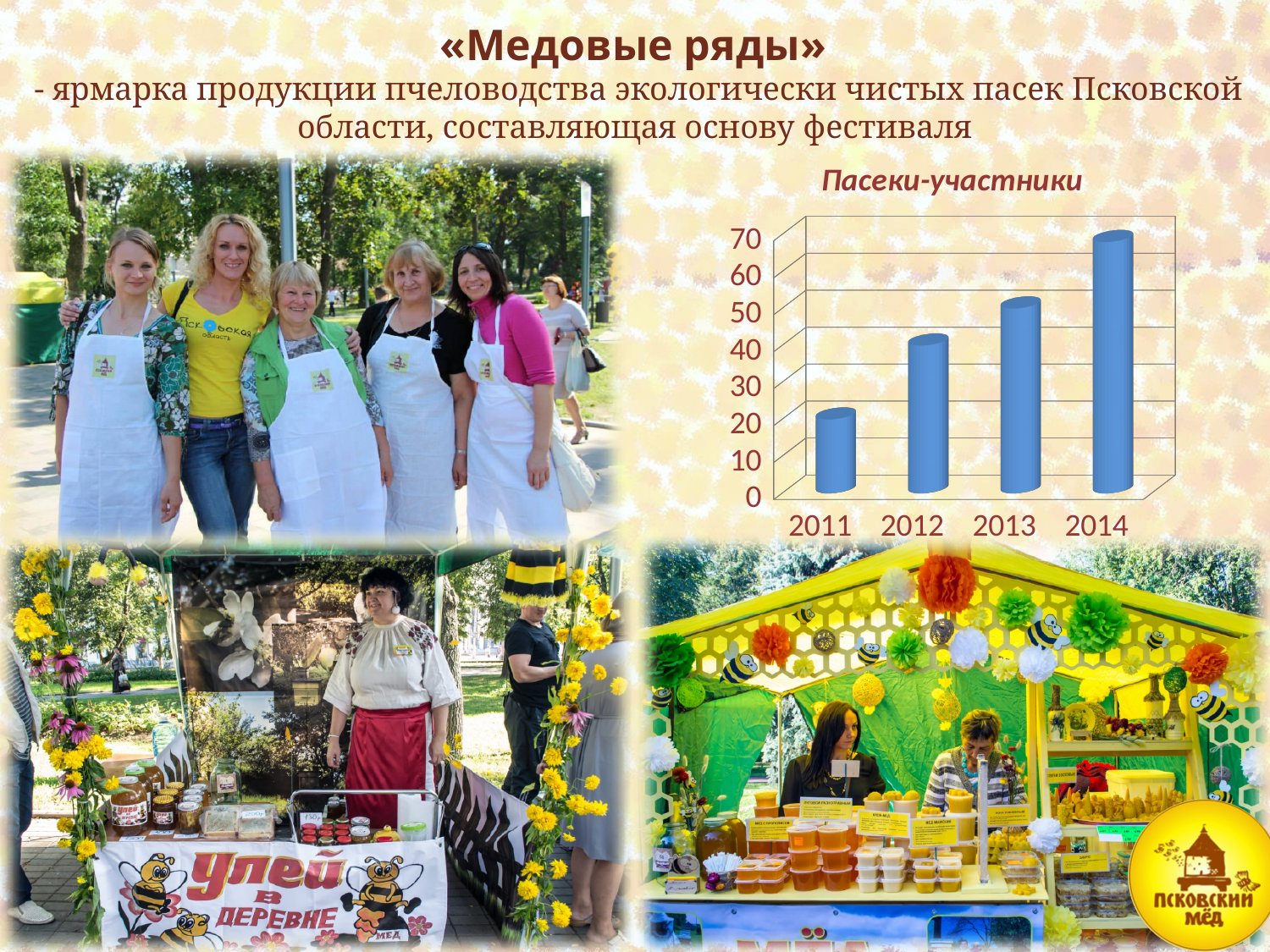
Which is larger, the value for 2012 or the value for 2013? 2013 What is the title of the chart on the slide? Пасеки-участники What kind of chart is shown on the slide? bar chart What is the value for 2011 in the chart? 20 Is the value for 2012 greater or less than 30? greater Is the value for 2014 greater or less than 60? greater Which year has the highest value in the chart? 2014 How many years are shown on the x axis of the chart? 4 Is the value for 2011 greater or less than 30? less Do the values in the chart rise or fall from 2011 to 2014? rise Which year has the lowest value in the chart? 2011